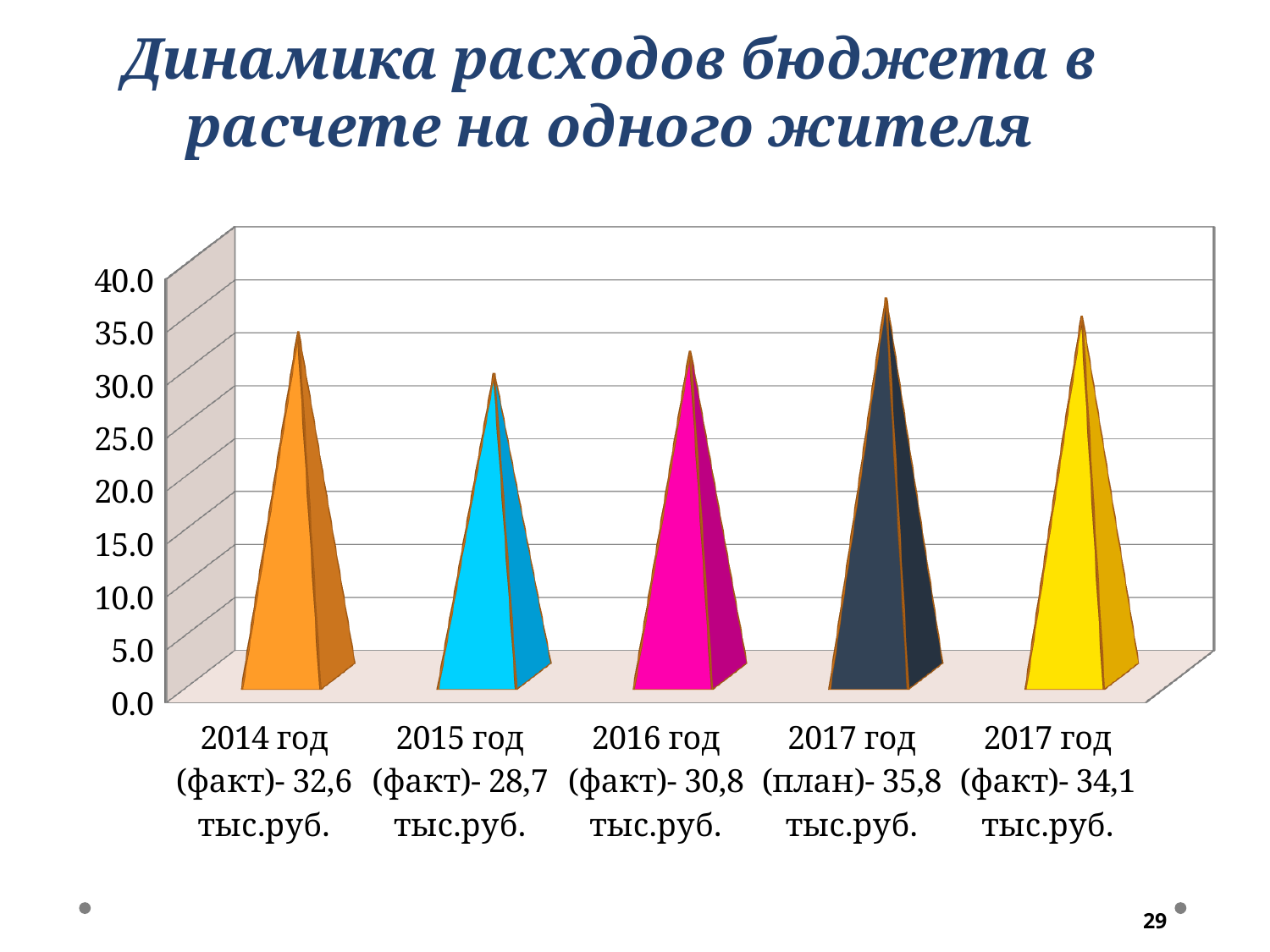
How many categories are shown on the chart? 5 What is the value for 2017 год (план)? 35,8 тыс.руб. What is the value for 2015 год (факт)? 28,7 тыс.руб. What is the difference between the 2017 год (план) value and the 2017 год (факт) value? 1,7 тыс.руб. Which category has the highest value? 2017 год (план) Is the value for 2015 год (факт) greater or less than 30.0? less What kind of chart is shown on the slide? bar chart Which category has the lowest value? 2015 год (факт) What is the title of the chart on the slide? Динамика расходов бюджета в расчете на одного жителя What is the value for 2014 год (факт)? 32,6 тыс.руб. Which is larger, the value for 2016 год (факт) or the value for 2014 год (факт)? 2014 год (факт) What is the difference between the 2014 год (факт) value and the 2015 год (факт) value? 3,9 тыс.руб.